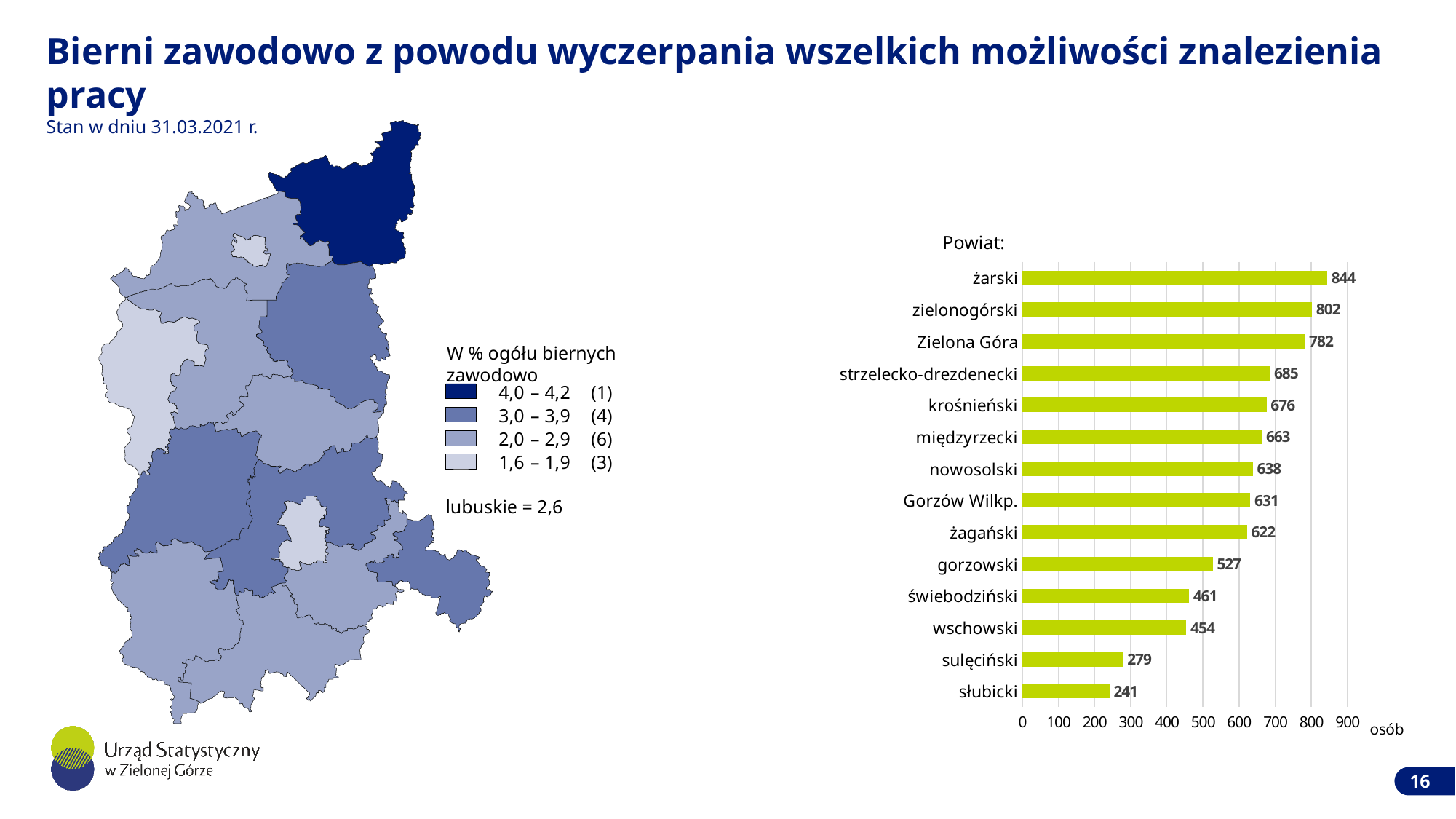
In the bar chart, which is larger: the value for gorzowski or the value for świebodziński? gorzowski In the bar chart, what is the value for sulęciński? 279 In the bar chart, what is the difference between the values for żarski and słubicki? 603 In the bar chart, what is the value for żarski? 844 In the bar chart, which powiat has the lowest value? słubicki In the bar chart, is the value for nowosolski greater or less than 600? greater How many powiats are shown in the bar chart? 14 In the bar chart, what is the difference between the values for zielonogórski and Zielona Góra? 20 In the bar chart, which powiat has the highest value? żarski What unit is shown at the end of the x axis of the bar chart? osób What kind of chart is shown on the right of the slide? bar chart In the bar chart, what is the value for Gorzów Wilkp.? 631